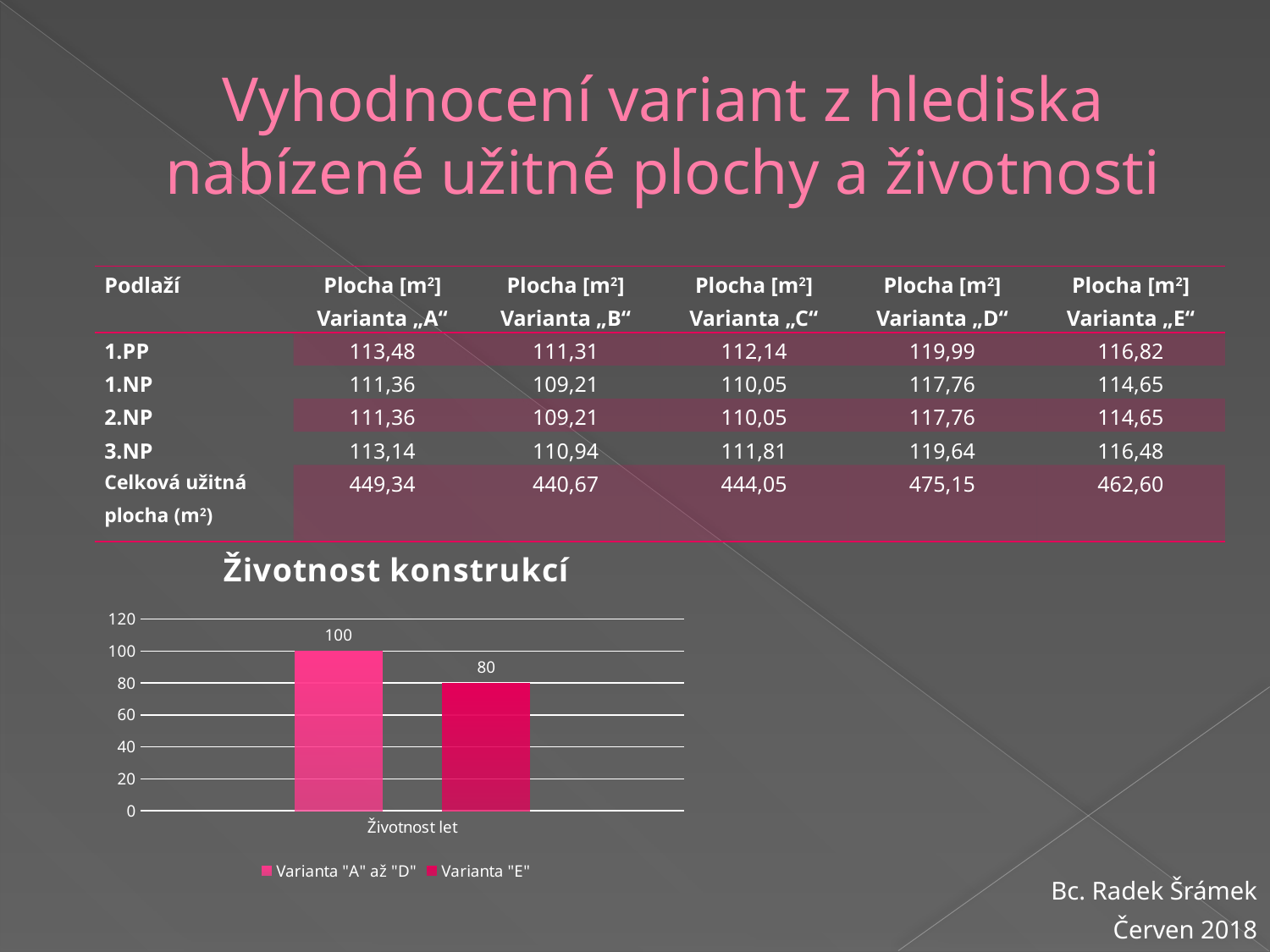
In the chart "Životnost konstrukcí", what is the difference between the value for Varianta "A" až "D" and the value for Varianta "E"? 20 How many categories are shown on the x axis of the chart "Životnost konstrukcí"? 1 What is the label of the category on the x axis of the chart "Životnost konstrukcí"? Životnost let In the chart "Životnost konstrukcí", is the value for Varianta "E" larger or smaller than the value for Varianta "A" až "D"? smaller How many series does the legend of the chart "Životnost konstrukcí" list? 2 In the chart "Životnost konstrukcí", what is the value for Varianta "A" až "D"? 100 In the chart "Životnost konstrukcí", which series has the lower value? Varianta "E" What is the title of the chart on the slide? Životnost konstrukcí In the chart "Životnost konstrukcí", which series has the higher value? Varianta "A" až "D" In the chart "Životnost konstrukcí", is the value for Varianta "E" greater or less than 60? greater What kind of chart is shown under the table? bar chart In the chart "Životnost konstrukcí", what is the value for Varianta "E"? 80